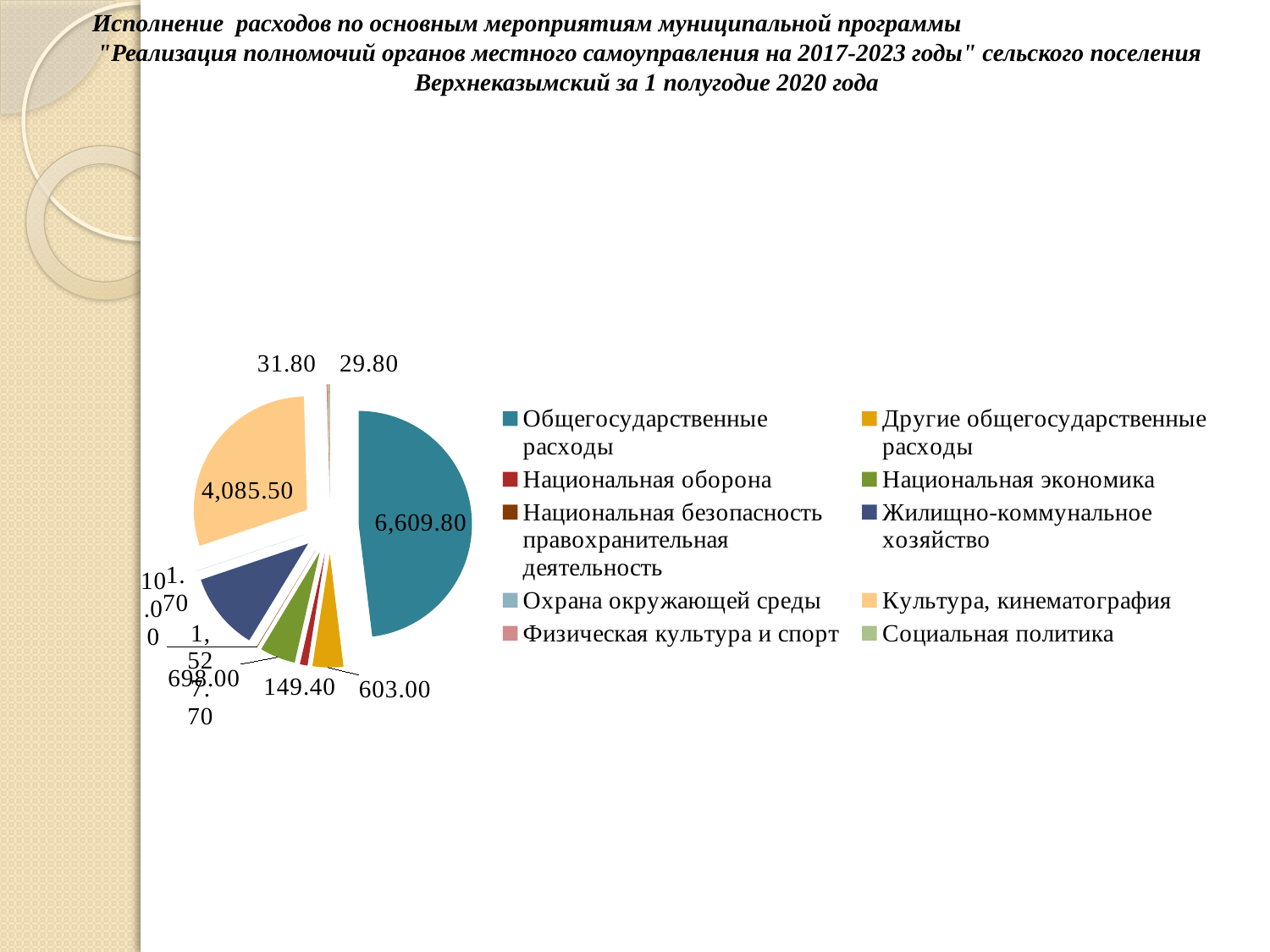
How many categories does the legend list? 10 What is the difference between Общегосударственные расходы and Культура, кинематография? 2,524.30 What colour is the slice for Общегосударственные расходы? teal What is the value for Национальная оборона? 149.40 Which is larger, Культура, кинематография or Жилищно-коммунальное хозяйство? Культура, кинематография What is the difference between Национальная экономика and Другие общегосударственные расходы? 95.00 Which category has the largest slice of the pie? Общегосударственные расходы What is the value for Национальная экономика? 698.00 What is the value for Общегосударственные расходы? 6,609.80 What kind of chart is shown on the slide? pie chart What is the value for Другие общегосударственные расходы? 603.00 What is the value for Культура, кинематография? 4,085.50